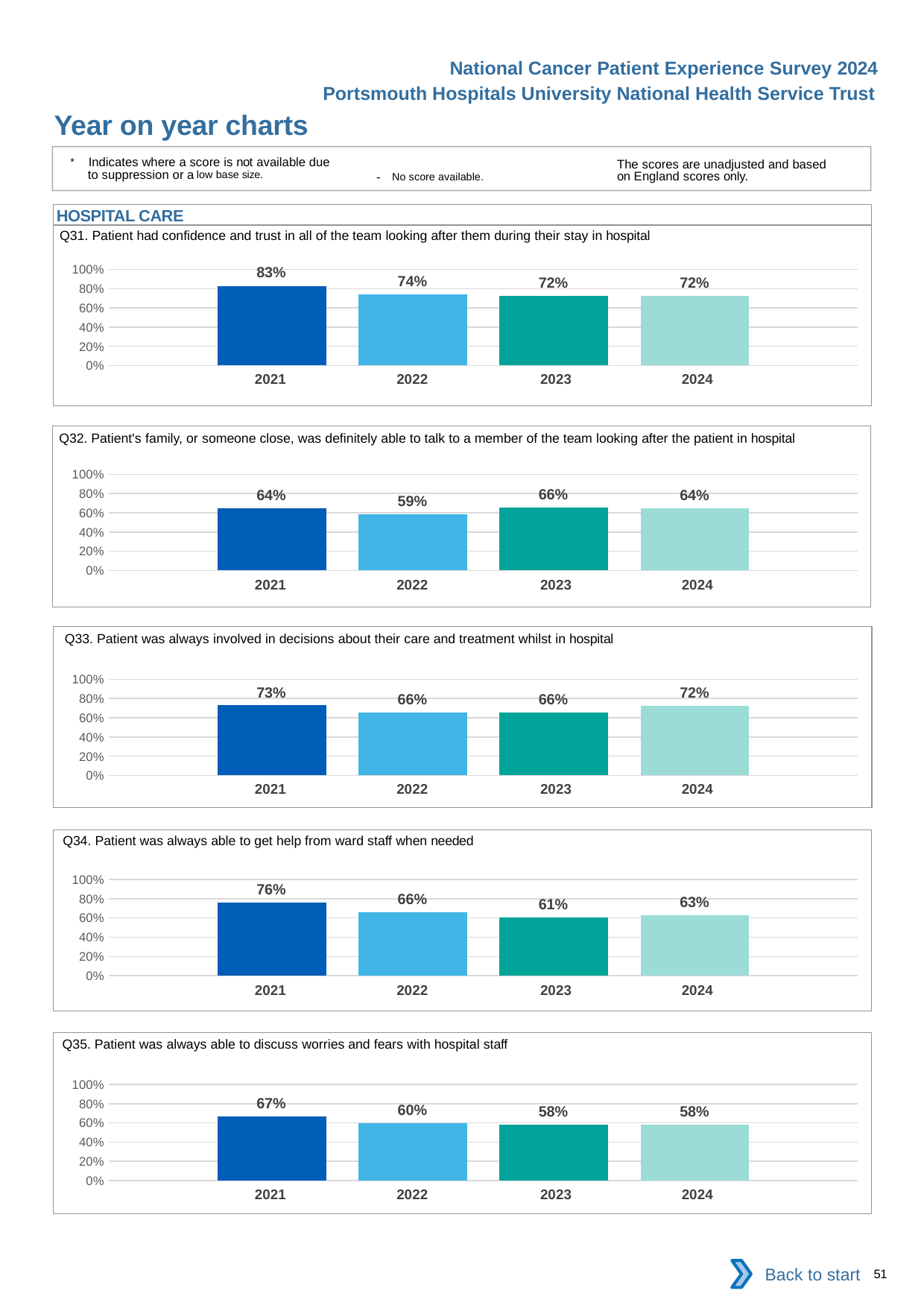
In the Q34 chart (able to get help from ward staff), what is the difference between the 2021 and 2023 values? 15 percentage points In the Q33 chart (involved in decisions about care and treatment), what is the difference between the 2021 and 2022 values? 7 percentage points In the Q32 chart (family able to talk to a member of the team), which year has the lowest value? 2022 In the Q33 chart (involved in decisions about care and treatment), what is the value for 2024? 72% In the Q31 chart (confidence and trust in the team), which year has the highest value? 2021 What kind of chart is the Q31 chart (confidence and trust in the team)? Bar chart How many years are plotted in the Q34 chart (able to get help from ward staff)? 4 In the Q35 chart (able to discuss worries and fears), what is the value for 2022? 60% In the Q34 chart (able to get help from ward staff), which is larger, the value for 2023 or the value for 2024? 2024 In the Q35 chart (able to discuss worries and fears), is the value for 2021 greater or less than 60%? greater In the Q31 chart (confidence and trust in the team), what is the value for 2021? 83% In the Q32 chart (family able to talk to a member of the team), what is the value for 2023? 66%